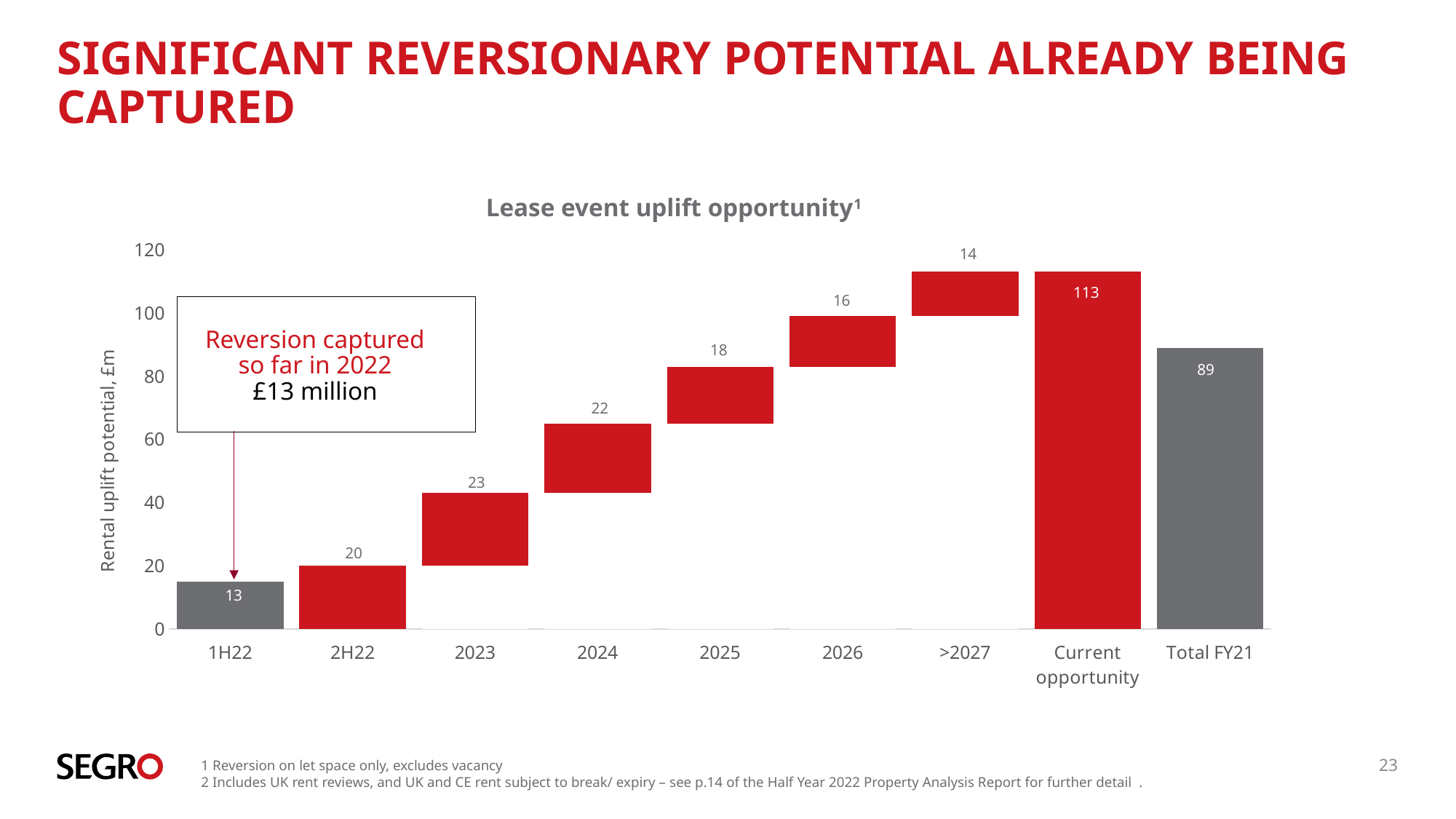
Which is larger, the value for 2H22 or the value for 2025? 2H22 What is the title of the chart? Lease event uplift opportunity What kind of chart is shown on the slide? Bar chart (waterfall) Do the yearly uplift values fall or rise from 2023 to >2027? Fall How many categories are shown on the x axis? 9 Which category has the highest value in the chart? Current opportunity Which category has the lowest value in the chart? 1H22 What is the value for 1H22? 13 What is the difference between the Current opportunity value and the Total FY21 value? 24 What is the value shown for the Current opportunity bar? 113 What is the value for Total FY21? 89 What is the value for 2023 in the Lease event uplift opportunity chart? 23